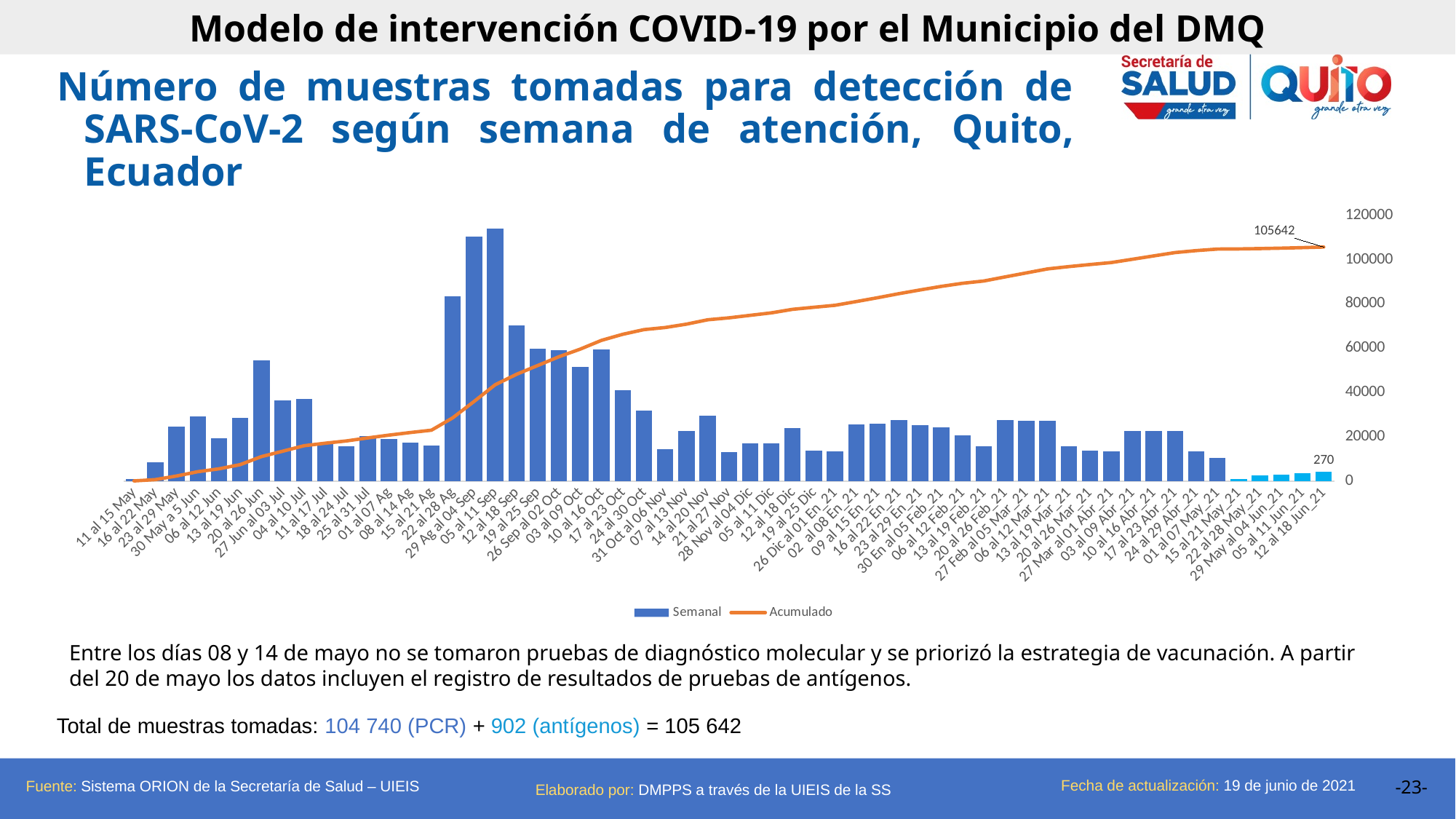
Does the Acumulado line rise or fall along the x axis? rises What are the two series named in the legend? Semanal and Acumulado Is the Acumulado value for 12 al 18 Jun_21 greater or less than 100000? greater Is the Semanal value for 11 al 15 May greater or less than 20000? less What is the Acumulado value for the week 12 al 18 Jun_21? 105642 Which week has the larger Semanal value, 29 Ag al 04 Sep or 19 al 25 Sep? 29 Ag al 04 Sep How many series does the legend list? 2 Which week has the larger Semanal value, 20 al 26 Jun or 11 al 17 Jul? 20 al 26 Jun Is the Semanal value for 12 al 18 Sep greater or less than 100000? less What colour is the Acumulado line? orange What is the Semanal value for the week 12 al 18 Jun_21? 270 What kind of chart is shown on the slide? bar chart with a line